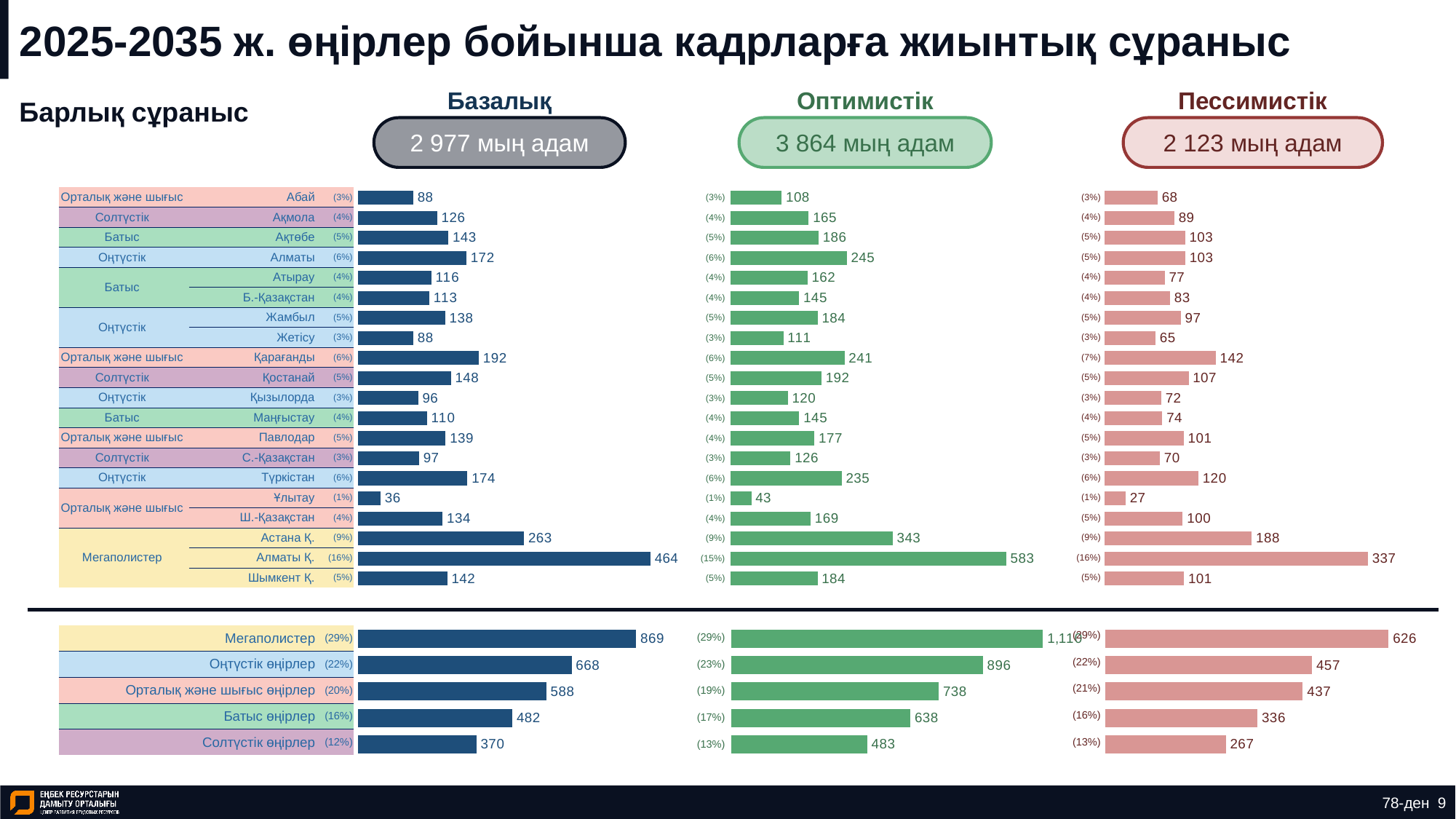
In the bottom Оптимистік chart, what is the value for Мегаполистер? 1,110 In the Пессимистік chart, what is the value for Астана Қ.? 188 How many categories are shown in the bottom (aggregated regions) chart for the Базалық scenario? 5 In the Базалық chart, what is the value for Алматы Қ.? 464 In the Оптимистік chart of individual regions, which region has the lowest value? Ұлытау In the bottom Базалық chart, what is the difference between the values for Мегаполистер and Солтүстік өңірлер? 499 What kind of chart is used to show the values on this slide? bar chart In the Оптимистік chart, what is the value for Қарағанды? 241 What total is shown in the box under the Пессимистік heading? 2 123 мың адам In the Базалық chart, what is the difference between the values for Астана Қ. and Шымкент Қ.? 121 In the Пессимистік chart, which is larger: the value for Түркістан or for Қарағанды? Қарағанды In the Базалық chart of individual regions, which region has the highest value? Алматы Қ.